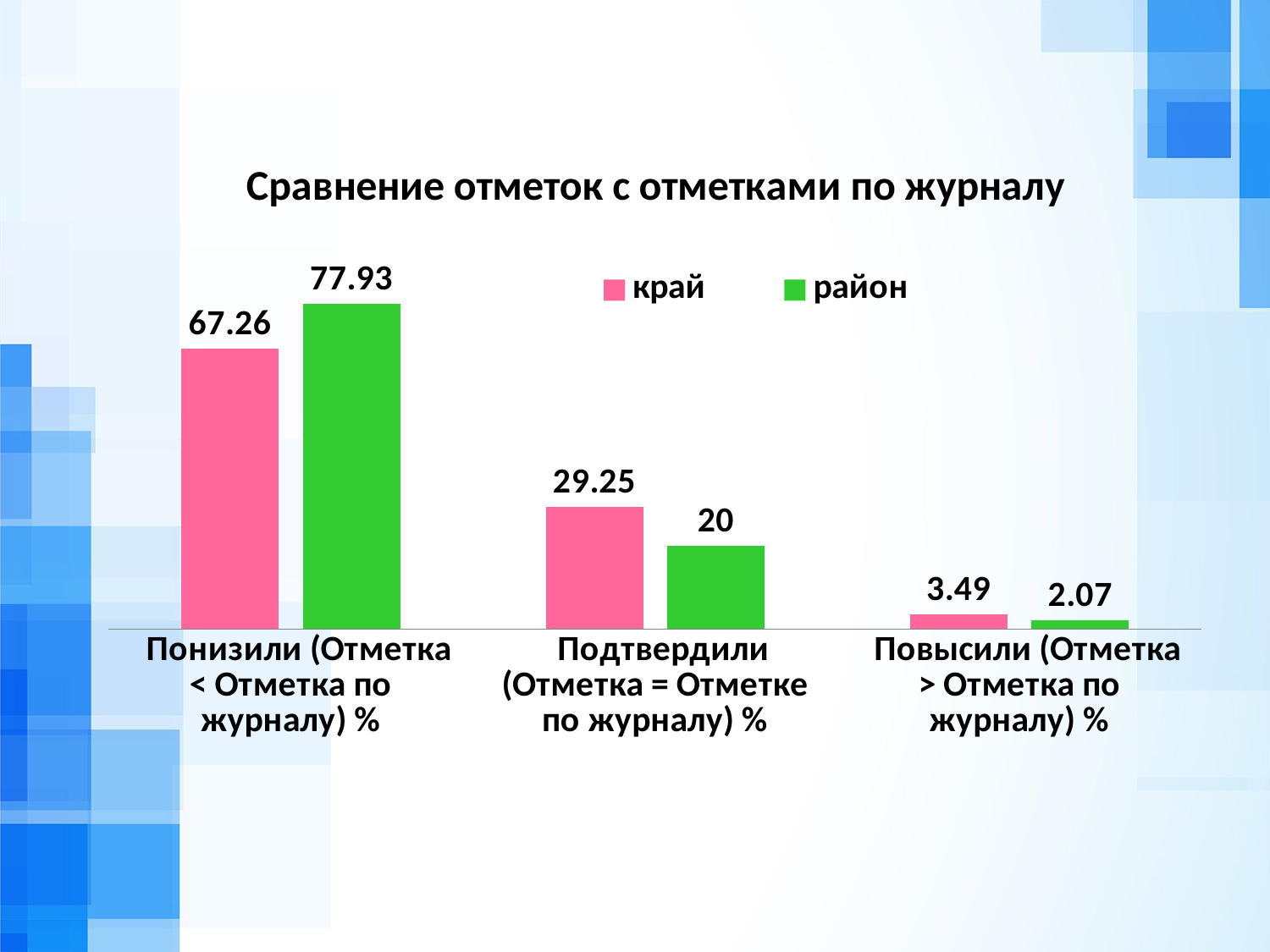
What is the value for край in the Понизили (Отметка < Отметка по журналу) % category? 67.26 How many categories are shown on the x axis? 3 What is the title of the chart? Сравнение отметок с отметками по журналу What is the value for край in the Повысили (Отметка > Отметка по журналу) % category? 3.49 What is the difference between район and край in the Понизили (Отметка < Отметка по журналу) % category? 10.67 Which category has the lowest value for край? Повысили (Отметка > Отметка по журналу) % What is the value for район in the Подтвердили (Отметка = Отметке по журналу) % category? 20 How many series does the legend list? 2 Do the values for край rise or fall from left to right across the categories? fall In the Подтвердили (Отметка = Отметке по журналу) % category, which series has the larger value, край or район? край What kind of chart is shown on the slide? bar chart Which category has the highest value for район? Понизили (Отметка < Отметка по журналу) %